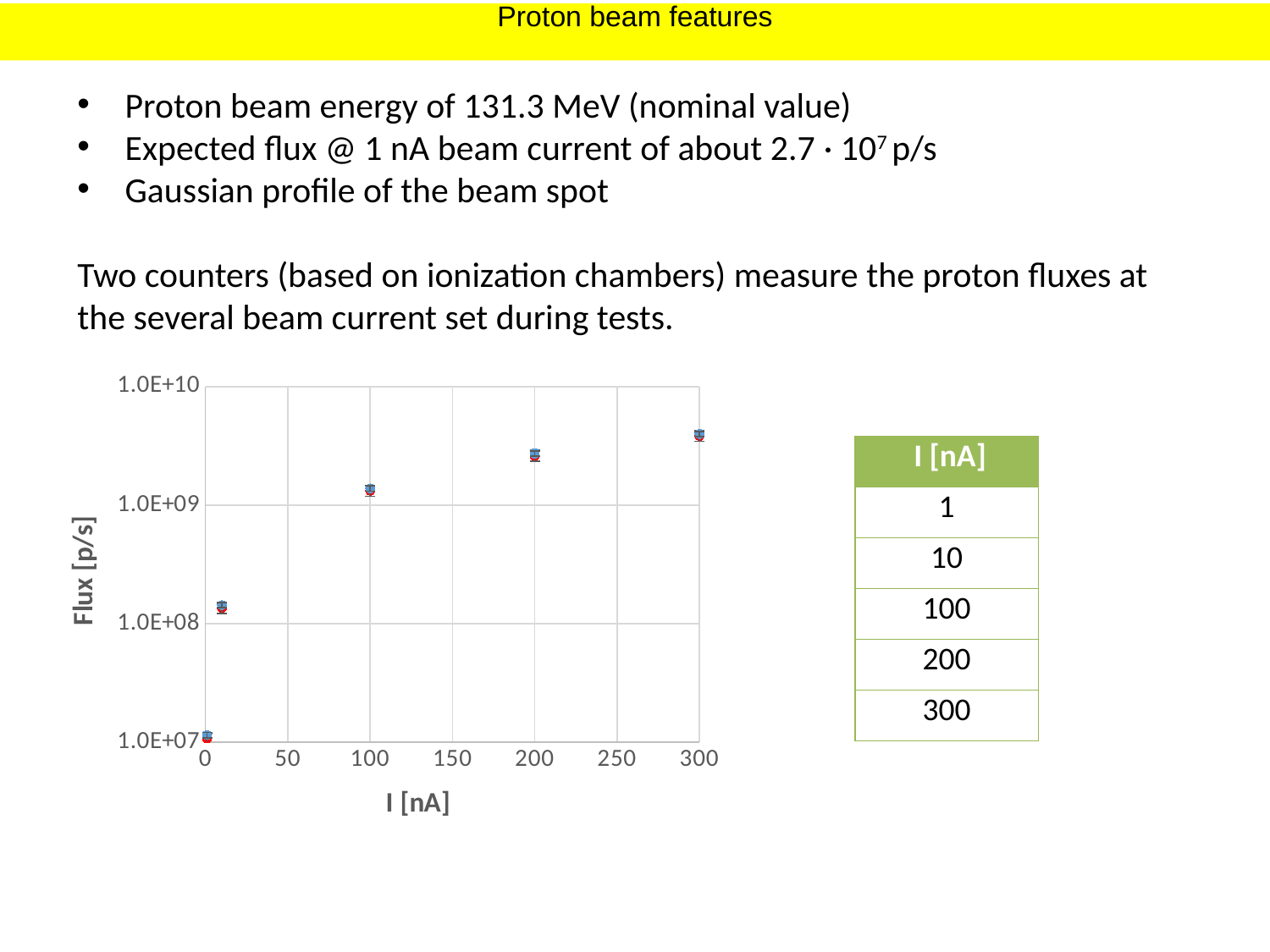
Which has the larger flux, the point at 200 nA or the point at 100 nA? 200 nA How many beam current values are plotted in the chart? 5 At which beam current is the measured flux lowest? 1 nA Is the flux at 100 nA greater or less than 1.0E+09 p/s? greater What is the label of the x axis of the chart? I [nA] At which beam current is the measured flux highest? 300 nA Is the flux at 10 nA greater or less than 1.0E+08 p/s? greater Does the flux rise or fall as the beam current I increases along the x axis? rise Is the flux at 300 nA greater or less than 1.0E+10 p/s? less What is the label of the y axis of the chart? Flux [p/s] What kind of chart is shown on the slide? scatter plot